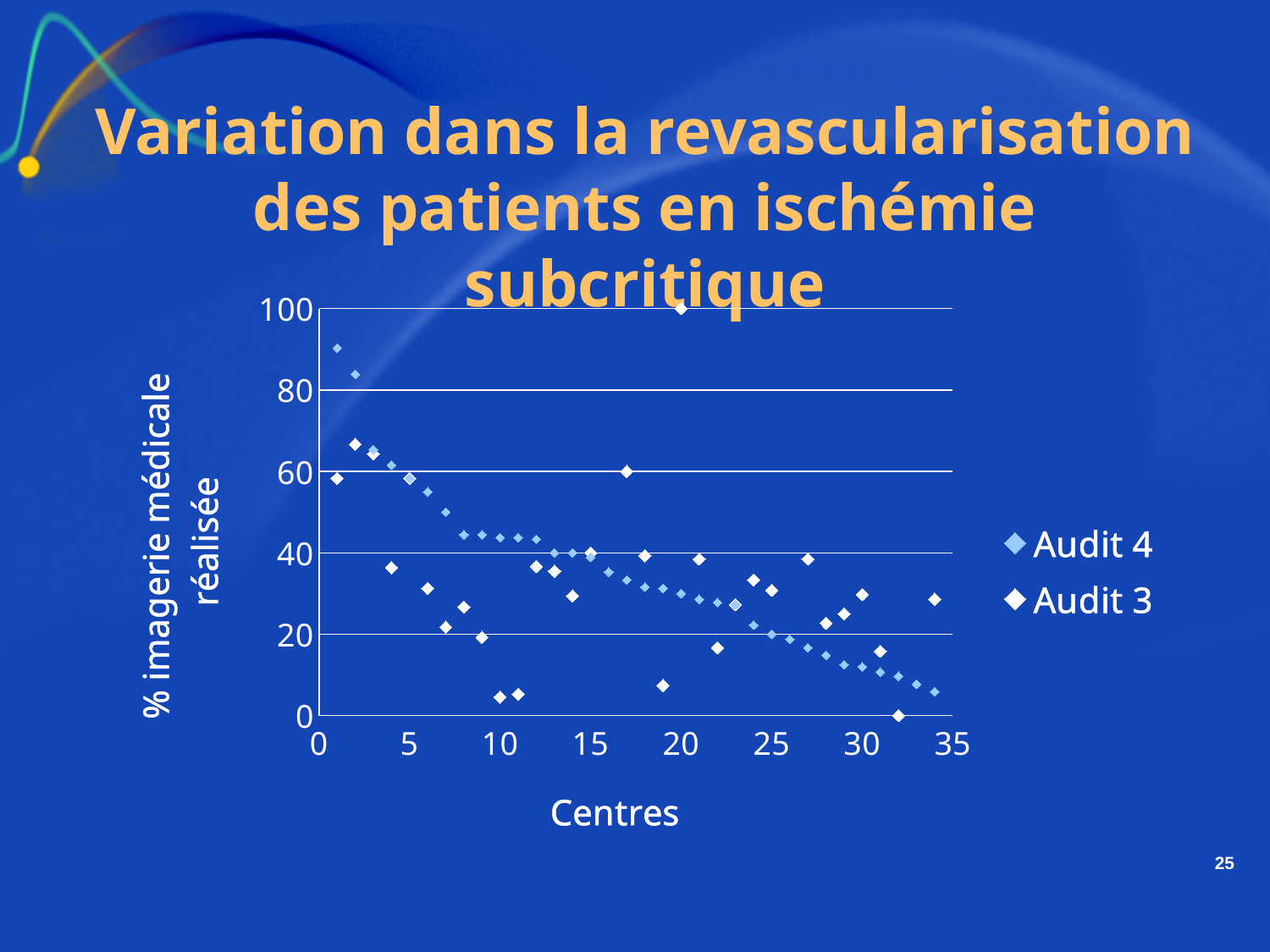
Is the Audit 3 value at centre 20 greater or less than 80? greater What kind of chart is shown on the slide? Scatter chart At which centre does Audit 3 have its lowest value? Centre 32 Is the Audit 3 value at centre 32 greater or less than 20? less At which centre does Audit 3 reach its highest value? Centre 20 How many series does the legend list? 2 What is the title of the x axis? Centres What are the two series named in the legend? Audit 4 and Audit 3 Do the Audit 4 values rise or fall as the centre number increases along the x axis? Fall At centre 20, which series has the larger value, Audit 3 or Audit 4? Audit 3 Is the Audit 3 value at centre 10 greater or less than 20? less